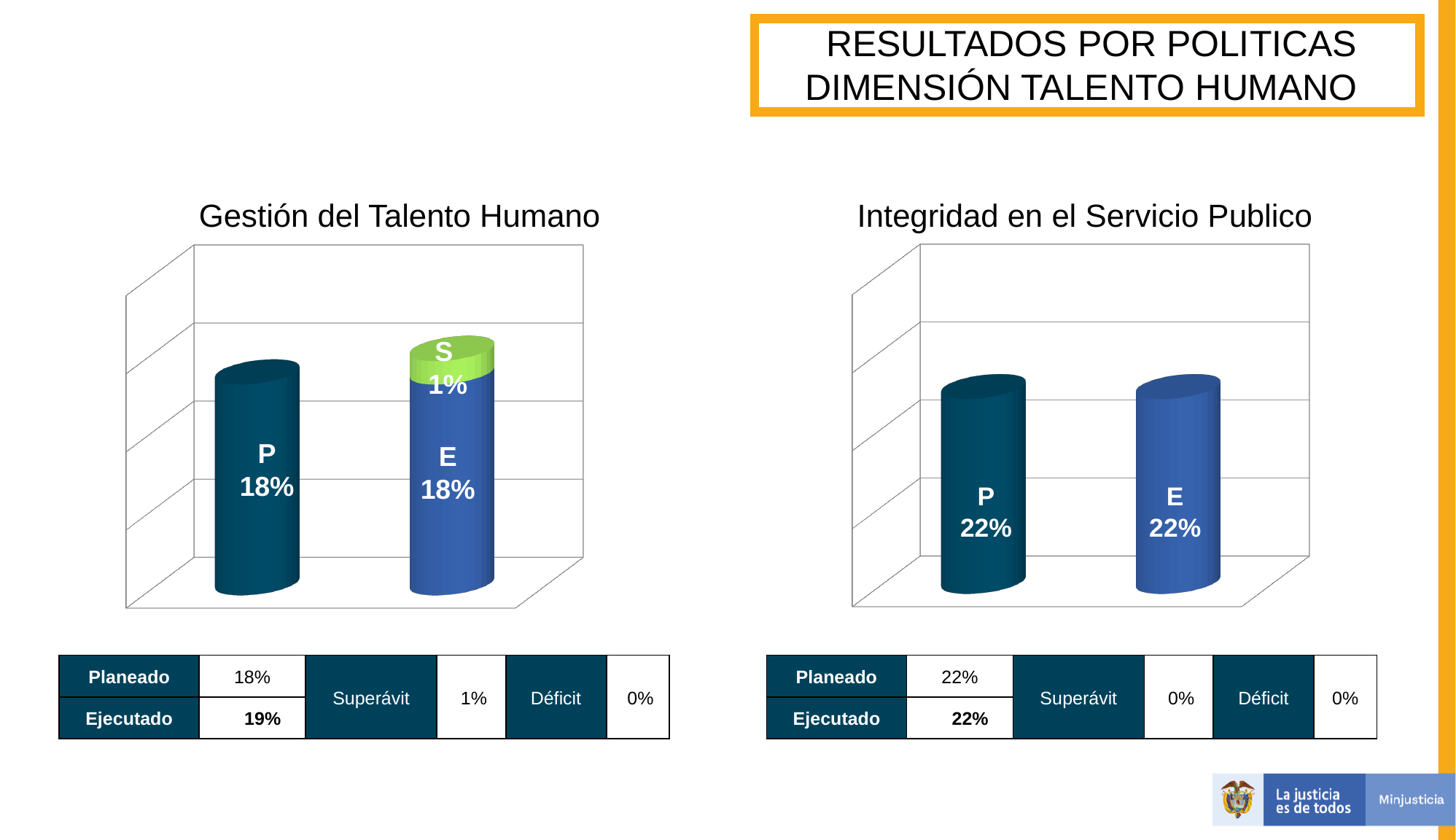
In the 'Gestión del Talento Humano' chart, what is the total of the stacked E bar (E plus S)? 19% In the 'Integridad en el Servicio Publico' chart, what is the value labelled P? 22% In the 'Gestión del Talento Humano' chart, what is the value of the S segment on top of the E bar? 1% What is the title of the chart on the right side of the slide? Integridad en el Servicio Publico In the 'Gestión del Talento Humano' chart, what is the value labelled E? 18% What kind of chart is 'Gestión del Talento Humano'? Bar chart How many charts are shown on the slide? 2 In the 'Integridad en el Servicio Publico' chart, what is the value labelled E? 22% In the 'Gestión del Talento Humano' chart, what is the value labelled P? 18% In the 'Gestión del Talento Humano' chart, what colour is the S segment? Green How many bars are shown in the 'Integridad en el Servicio Publico' chart? 2 In the 'Integridad en el Servicio Publico' chart, what is the difference between the P and E values? 0%